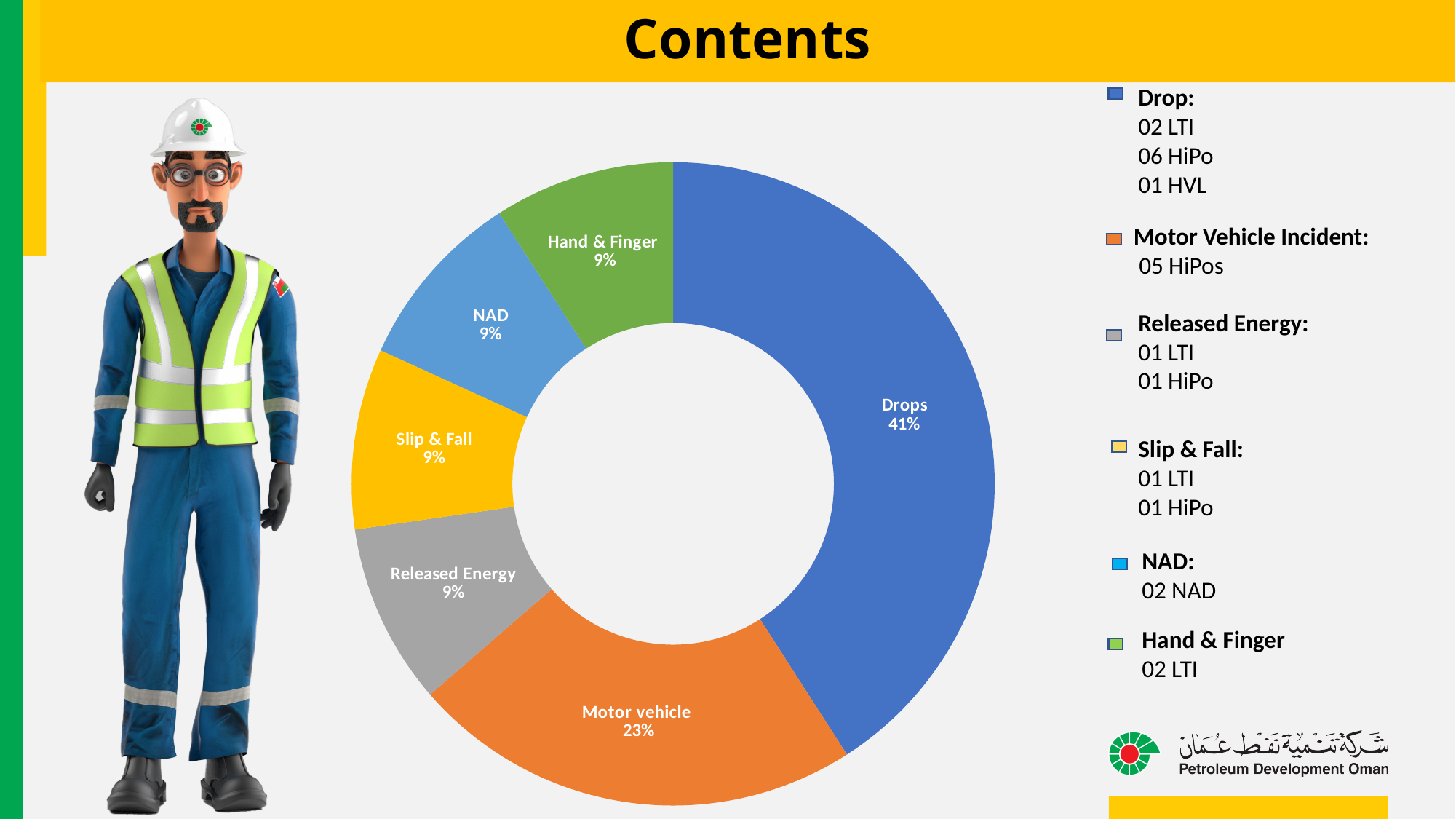
What percentage does the Hand & Finger slice show? 9% What is the difference in percentage points between the Motor vehicle slice and the Slip & Fall slice? 14% Which is larger, the Motor vehicle slice or the NAD slice? Motor vehicle What percentage does the Released Energy slice show? 9% What kind of chart is shown on the slide? doughnut chart How many categories are shown in the chart? 6 What share of the chart does the Drops slice represent? 41% What percentage does the Motor vehicle slice show? 23% What percentage does the Drops slice show? 41% Which category has the largest slice of the chart? Drops What is the difference in percentage points between the Drops slice and the Motor vehicle slice? 18% What colour is the Motor vehicle slice? orange